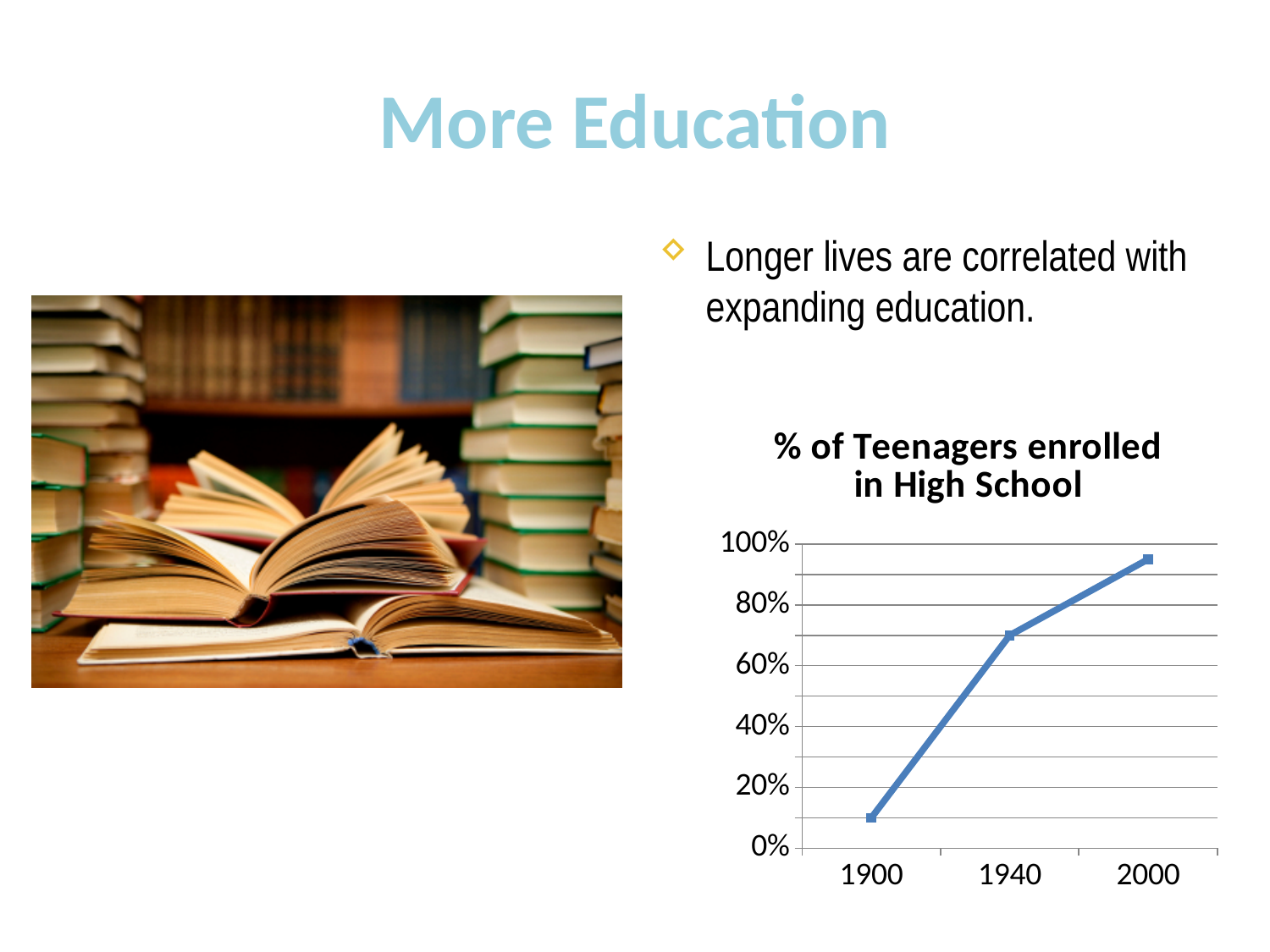
Which year has a larger value, 1900 or 1940? 1940 What is the title of the chart? % of Teenagers enrolled in High School Which year has the lowest percentage of teenagers enrolled in high school? 1900 Which year has the highest percentage of teenagers enrolled in high school? 2000 Is the value for 2000 greater or less than 80%? greater Is the value for 1940 greater or less than 80%? less What kind of chart is shown under the title "% of Teenagers enrolled in High School"? line chart What is the highest value shown on the chart's vertical axis? 100% Is the value for 1900 greater or less than 20%? less How many data points are plotted on the line chart? 3 Do the values rise or fall from 1900 to 2000? rise